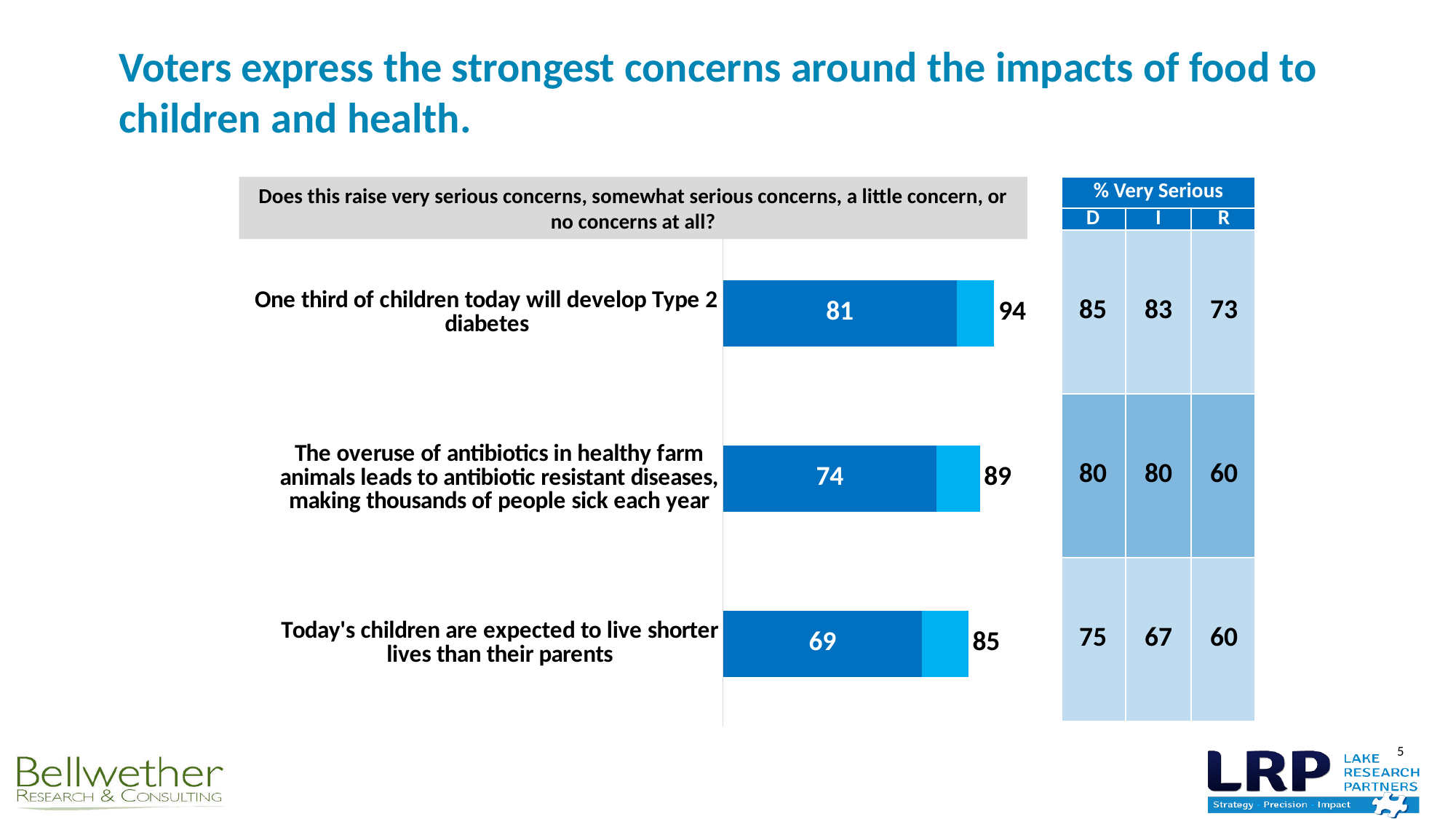
Do the total values rise or fall going from the top bar to the bottom bar? fall What is the total value shown at the end of the bar for "The overuse of antibiotics in healthy farm animals leads to antibiotic resistant diseases, making thousands of people sick each year"? 89 Which statement has the highest total value in the bar chart? One third of children today will develop Type 2 diabetes Which statement has the lowest dark blue (very serious) value? Today's children are expected to live shorter lives than their parents How many statements (categories) are plotted in the bar chart? 3 Is the dark blue value for the antibiotics statement larger or smaller than the dark blue value for the Type 2 diabetes statement? smaller In the "% Very Serious" table, what is the value for D for the antibiotics statement? 80 What is the difference between the total values for the Type 2 diabetes statement and the shorter lives statement? 9 In the "% Very Serious" table, what is the value for R for the Type 2 diabetes statement? 73 What is the dark blue (very serious) value for "One third of children today will develop Type 2 diabetes"? 81 What kind of chart is shown on the slide? bar chart What is the dark blue value for "Today's children are expected to live shorter lives than their parents"? 69